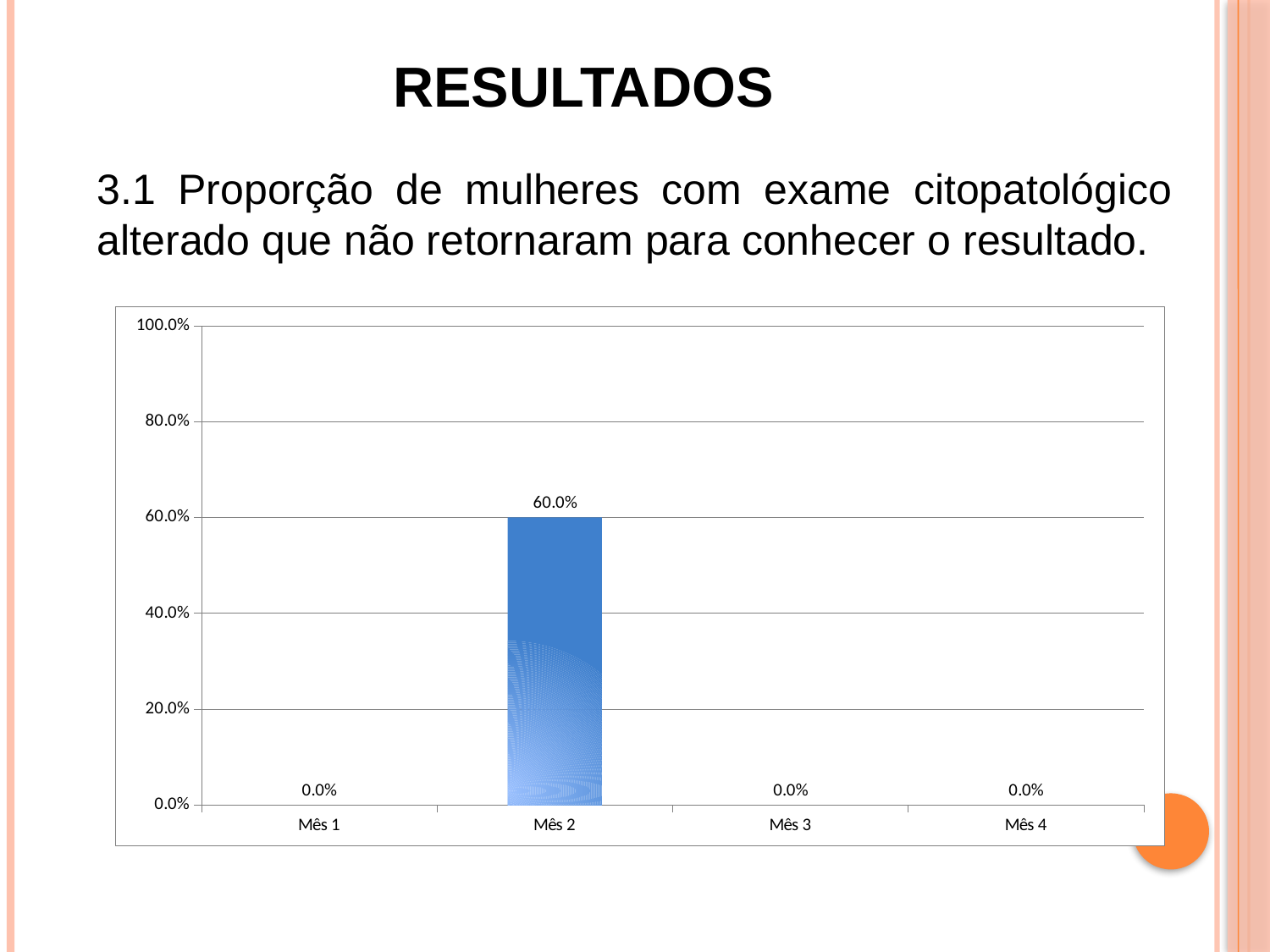
How many months are shown on the x axis? 4 What kind of chart is shown on the slide? bar chart Is the value for Mês 2 greater or less than 40.0%? greater What is the value for Mês 3? 0.0% What is the value for Mês 4? 0.0% What colour is the bar for Mês 2? blue What is the value for Mês 2? 60.0% Which month has the highest value? Mês 2 What is the value for Mês 1? 0.0% What is the maximum value shown on the y axis? 100.0% Which is larger, the value for Mês 2 or the value for Mês 3? Mês 2 What is the difference between the values for Mês 2 and Mês 1? 60.0%